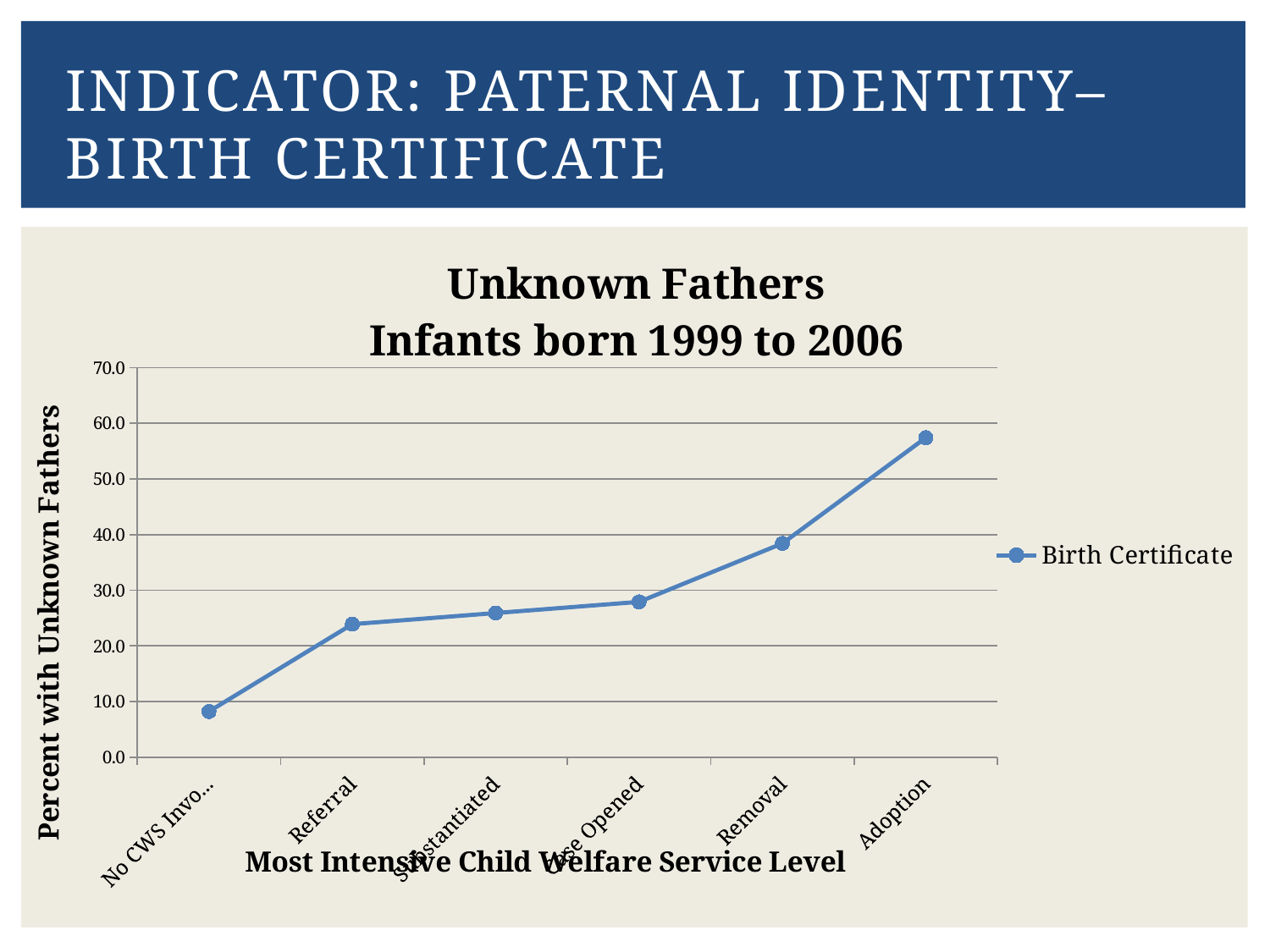
Do the values rise or fall moving from left to right along the x axis? rise Which category has the lowest percent with unknown fathers? No CWS Invo... What kind of chart is shown on the slide? line chart Which category has the highest percent with unknown fathers? Adoption How many series does the legend list? 1 What is the title of the chart? Unknown Fathers Infants born 1999 to 2006 What is the name of the series shown in the legend? Birth Certificate How many service-level categories are plotted on the x axis? 6 Is the value for Removal greater or less than 40.0? less Which has a higher percent with unknown fathers, Removal or Referral? Removal Is the value for Referral greater or less than 20.0? greater Is the value for Adoption greater or less than 50.0? greater